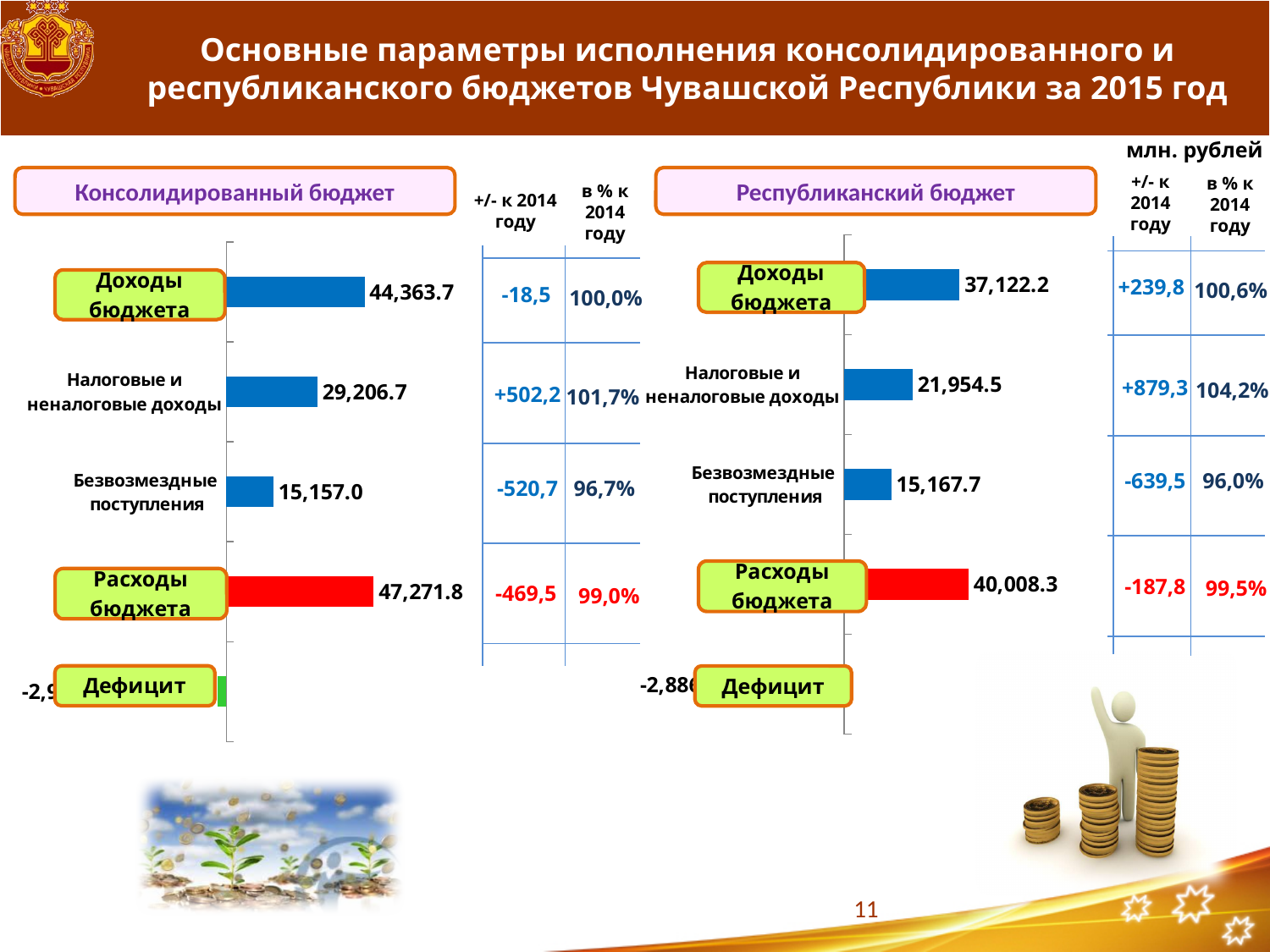
In the Консолидированный бюджет chart, what is the value for Доходы бюджета? 44,363.7 In the Консолидированный бюджет chart, what is the difference between Расходы бюджета and Доходы бюджета? 2,908.1 In the Консолидированный бюджет chart, what colour is the bar for Расходы бюджета? Red In the Республиканский бюджет chart, which is larger: Доходы бюджета or Расходы бюджета? Расходы бюджета In the Республиканский бюджет chart, which of the labelled positive categories has the smallest value? Безвозмездные поступления In the Республиканский бюджет chart, what is the value for Безвозмездные поступления? 15,167.7 What type of chart is used for the Консолидированный бюджет? Bar chart In the Республиканский бюджет chart, what is the difference between Доходы бюджета and Налоговые и неналоговые доходы? 15,167.7 How many categories are shown in the Республиканский бюджет chart? 5 In the Консолидированный бюджет chart, which category has the longest bar? Расходы бюджета In the Консолидированный бюджет chart, what is the value for Налоговые и неналоговые доходы? 29,206.7 In the Республиканский бюджет chart, what is the value for Расходы бюджета? 40,008.3